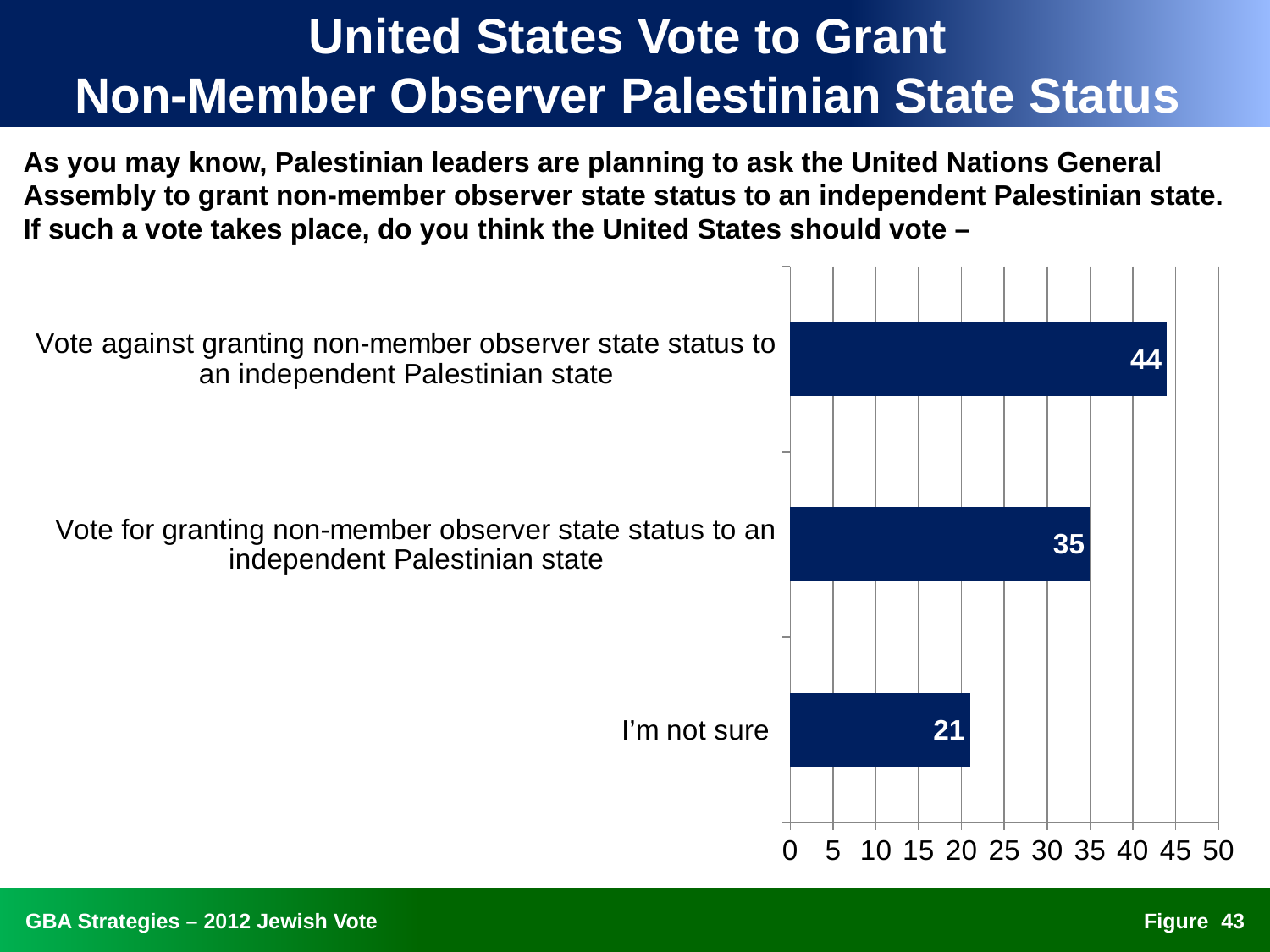
Which is larger: the value for voting for granting status or the value for "I'm not sure"? Vote for granting non-member observer state status to an independent Palestinian state What is the value for "I'm not sure"? 21 What is the difference between the value for voting for granting status and the value for "I'm not sure"? 14 What is the value for "Vote for granting non-member observer state status to an independent Palestinian state"? 35 Which category has the lowest value? I'm not sure Which category has the highest value? Vote against granting non-member observer state status to an independent Palestinian state How many categories are shown in the chart? 3 What is the value for "Vote against granting non-member observer state status to an independent Palestinian state"? 44 Is the value for "Vote against granting non-member observer state status to an independent Palestinian state" greater or less than 40? greater What is the maximum value shown on the horizontal axis? 50 What is the difference between the value for voting against and the value for voting for granting non-member observer state status? 9 What kind of chart is shown on the slide? Bar chart